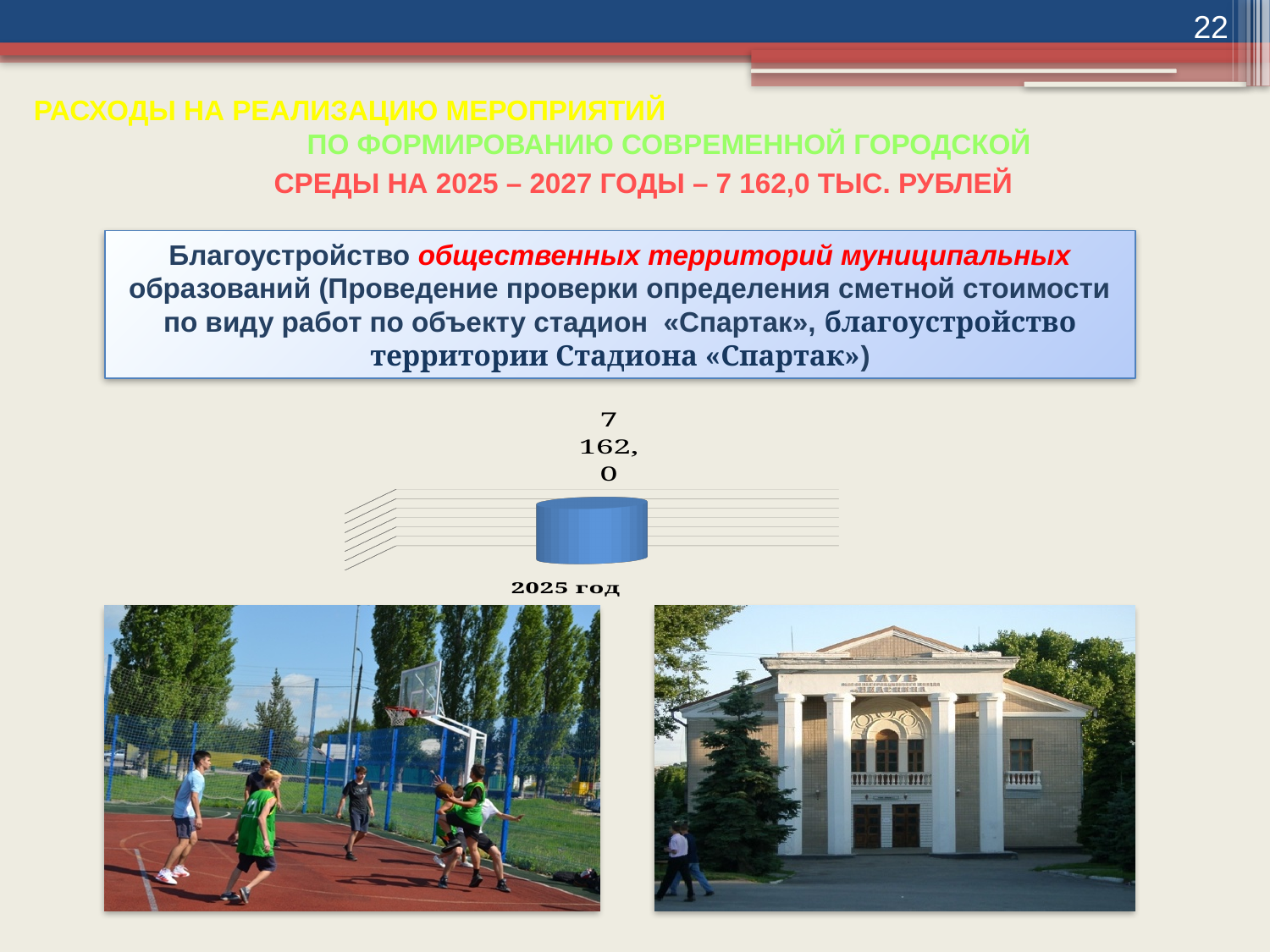
What colour is the bar in the chart? blue What is the category label shown under the bar in the chart? 2025 год How many bars does the chart contain? 1 What kind of chart is shown on the slide? bar chart How many categories are plotted in the chart? 1 What value is shown for 2025 год in the chart? 7 162,0